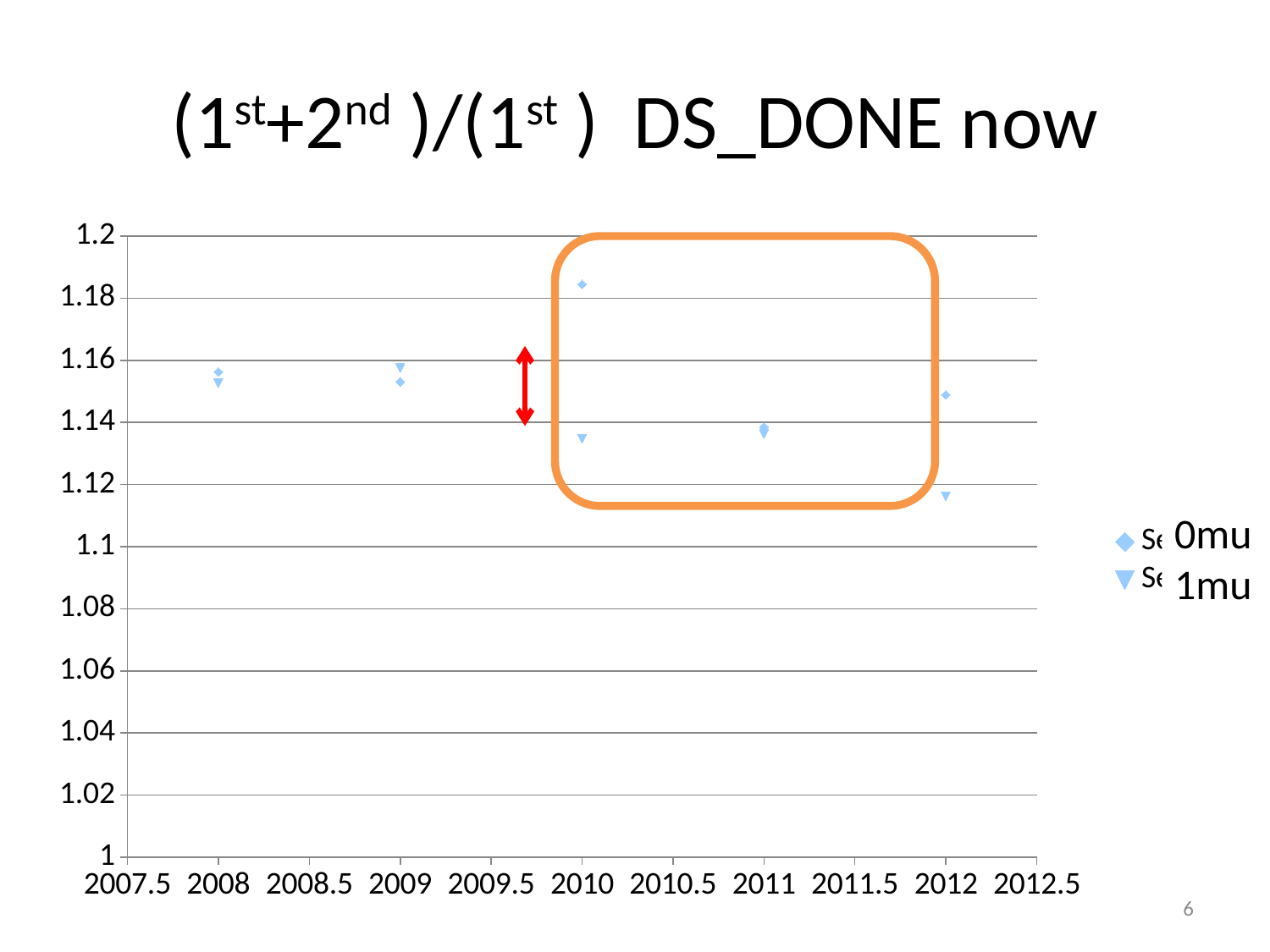
At 2010, which series has the larger value, 0mu or 1mu? 0mu How many series does the legend list? 2 Is the value for 1mu at 2012 greater or less than 1.14? less Is the value for 1mu at 2008 greater or less than 1.14? greater For the 0mu series, at which year is the value highest? 2010 Is the value for 0mu at 2011 greater or less than 1.16? less At 2012, which series has the larger value, 0mu or 1mu? 0mu How many x-axis years have plotted points? 5 For the 1mu series, at which year is the value lowest? 2012 What are the two series named in the legend? 0mu and 1mu What kind of chart is shown on the slide? scatter chart